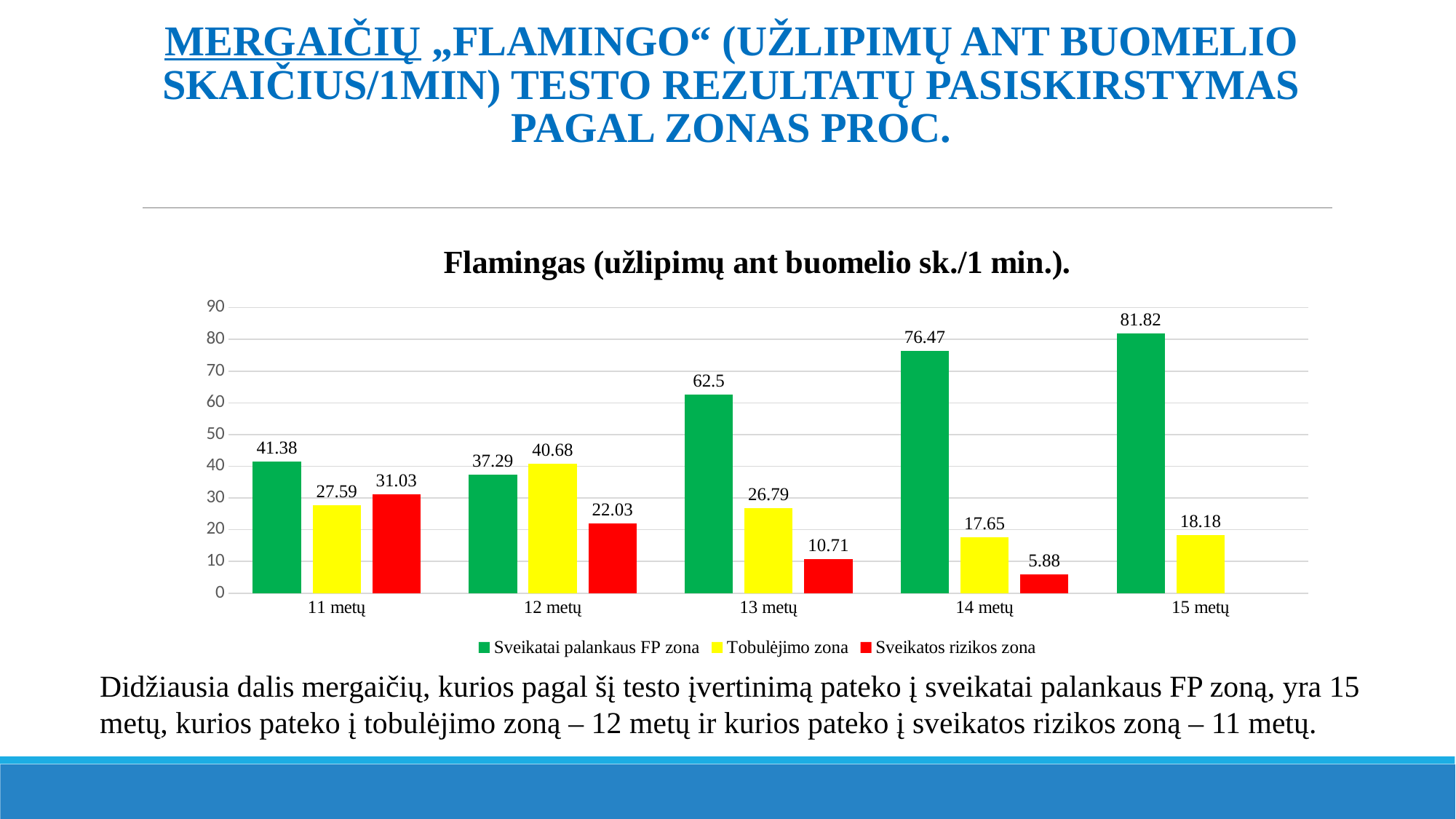
What is the difference between the Sveikatai palankaus FP zona values for 15 metų and 14 metų? 5.35 What is the value for Sveikatos rizikos zona for 14 metų? 5.88 What is the value for Tobulėjimo zona for 12 metų? 40.68 How many age groups are shown on the x axis? 5 What is the value for Sveikatai palankaus FP zona for 13 metų? 62.5 What type of chart is shown on the slide? bar chart How many series does the legend list? 3 Which age group has the lowest value for Sveikatos rizikos zona among those with a red bar? 14 metų Which age group has the highest value for Sveikatai palankaus FP zona? 15 metų Does the value for Sveikatai palankaus FP zona rise or fall from 12 metų to 15 metų? rise Is the value for Sveikatai palankaus FP zona for 14 metų greater or less than 70? greater Which is larger for 12 metų: Sveikatai palankaus FP zona or Tobulėjimo zona? Tobulėjimo zona